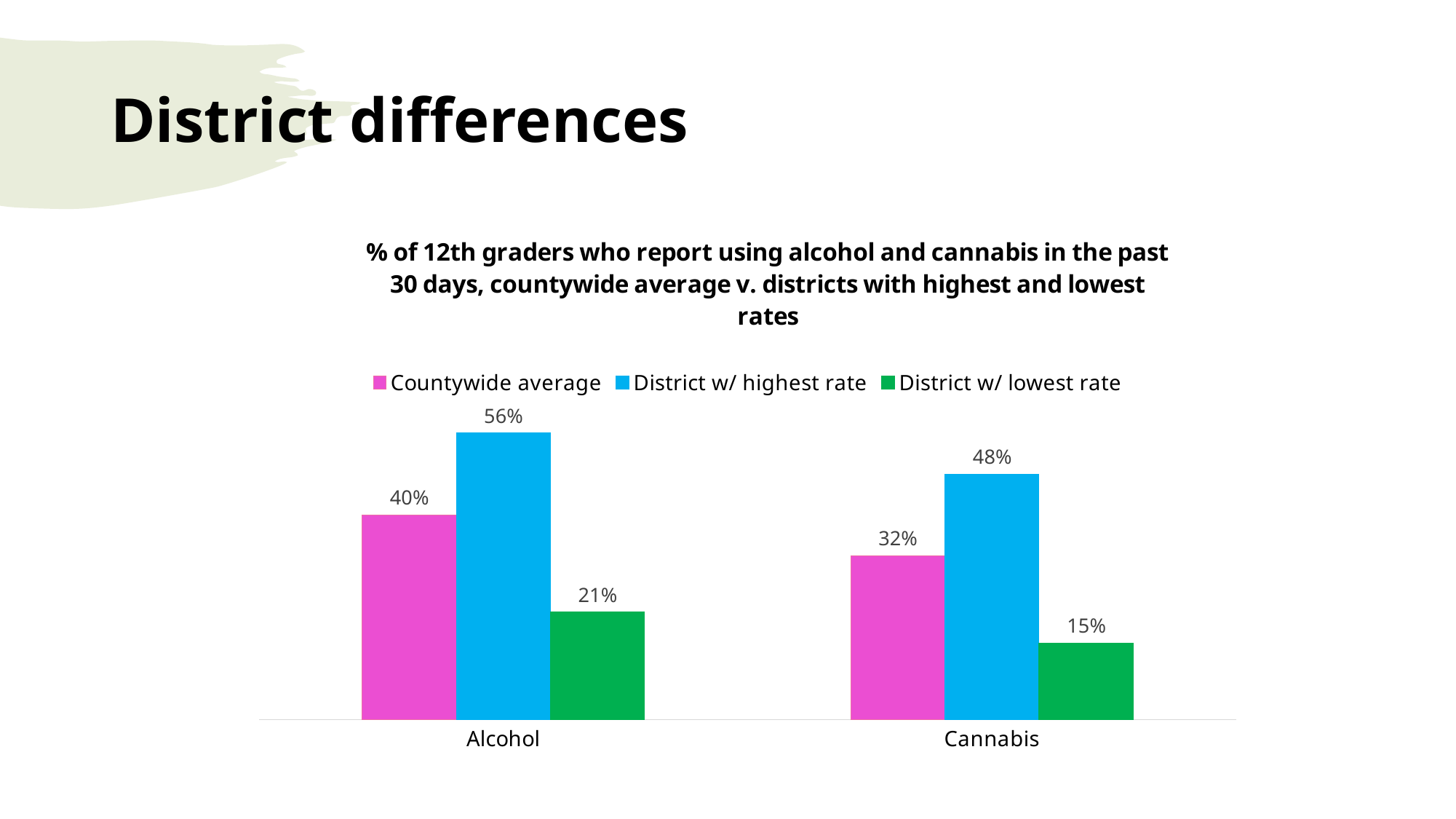
How many series does the legend list? 3 What is the value for District w/ highest rate for Cannabis? 48% What is the countywide average for Alcohol? 40% Which is larger: the District w/ lowest rate value for Alcohol or for Cannabis? Alcohol What is the countywide average for Cannabis? 32% What is the value for District w/ lowest rate for Alcohol? 21% What kind of chart is shown on the slide? Bar chart Which series has the highest value for Alcohol? District w/ highest rate What is the difference between the countywide average for Alcohol and the countywide average for Cannabis? 8% How many categories are shown on the x axis? 2 What is the difference between the District w/ highest rate and District w/ lowest rate values for Alcohol? 35% Which series has the lowest value for Cannabis? District w/ lowest rate